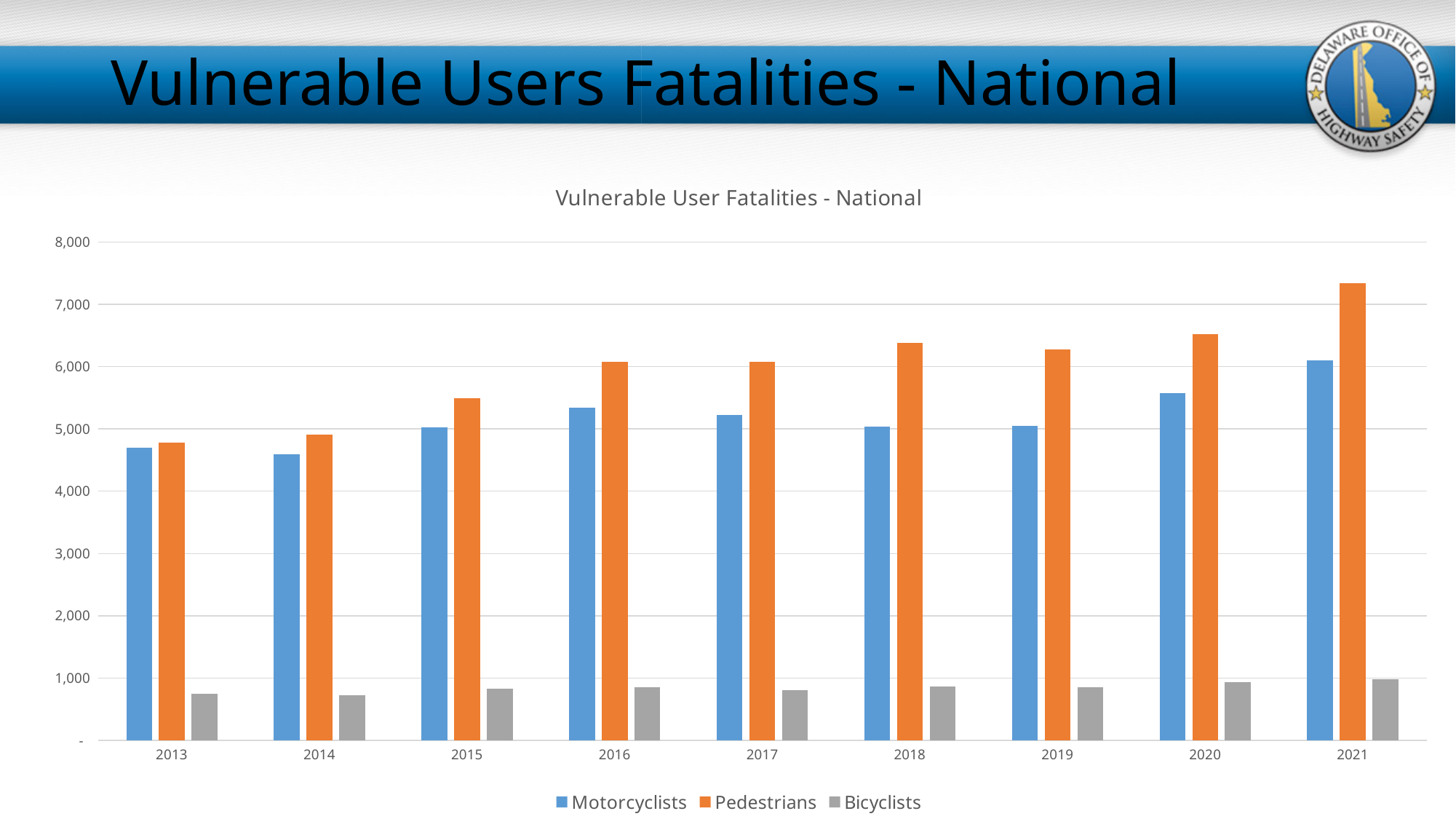
What kind of chart is shown on the slide? Bar chart In which year are Motorcyclists fatalities highest? 2021 In 2016, which is larger: Motorcyclists or Pedestrians fatalities? Pedestrians What colour represents the Pedestrians series? Orange Do Pedestrians fatalities generally rise or fall from 2013 to 2021? rise Is the value for Pedestrians in 2015 greater or less than 5,000? greater Is the value for Motorcyclists in 2013 greater or less than 5,000? less How many years are shown on the x axis? 9 In which year are Pedestrians fatalities highest? 2021 How many series does the legend list? 3 Is the value for Pedestrians in 2021 greater or less than 7,000? greater